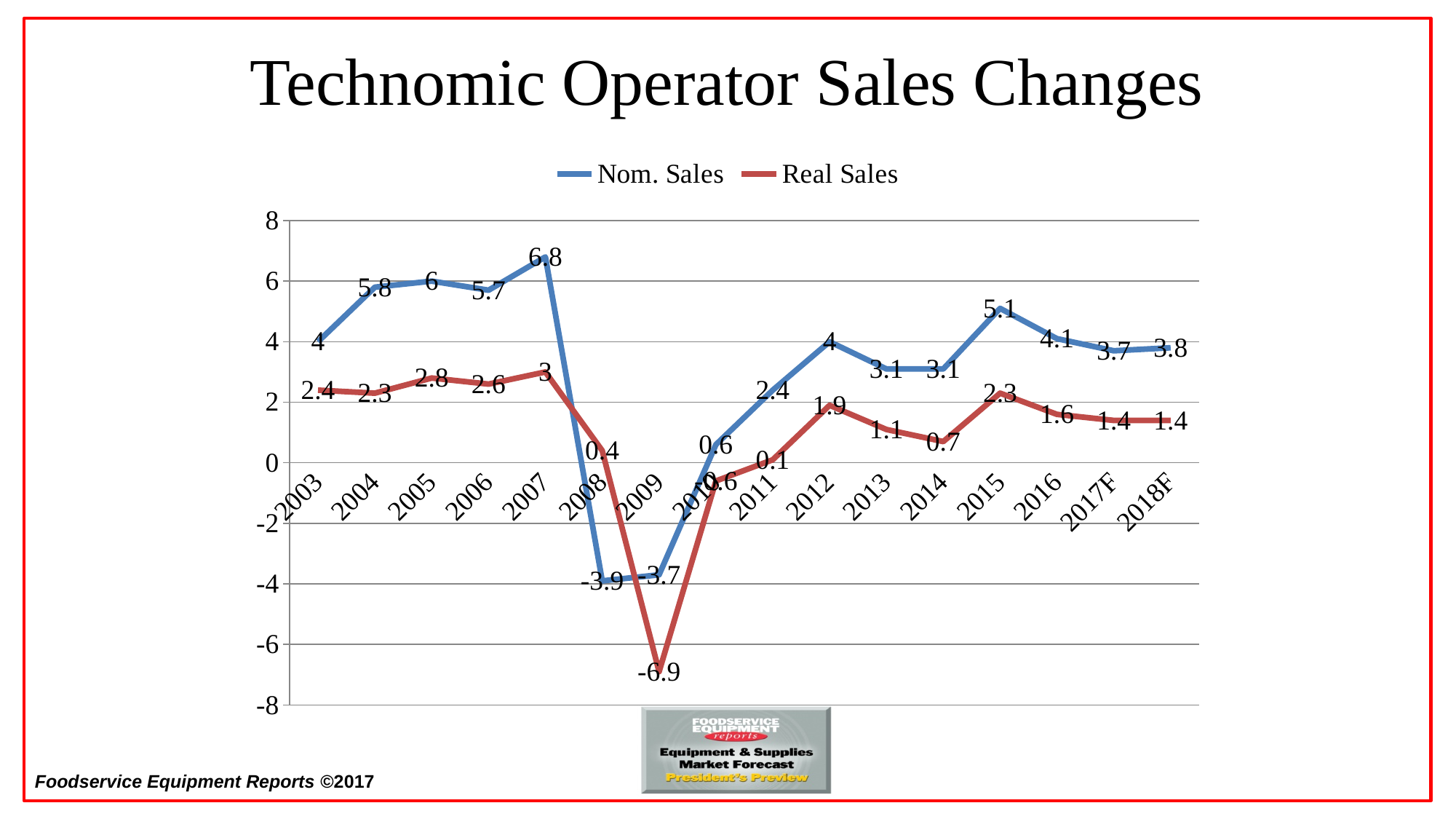
Which is larger in 2008, Nom. Sales or Real Sales? Real Sales How many series does the legend list? 2 What is the Nom. Sales value for 2015? 5.1 What is the Real Sales value for 2018F? 1.4 What is the difference between Nom. Sales and Real Sales in 2012? 2.1 In which year is Real Sales lowest? 2009 What is the Real Sales value for 2009? -6.9 What is the title of the chart? Technomic Operator Sales Changes What type of chart is shown on the slide? line chart What is the Nom. Sales value for 2007? 6.8 How many years are plotted along the x axis? 16 In which year is Nom. Sales highest? 2007